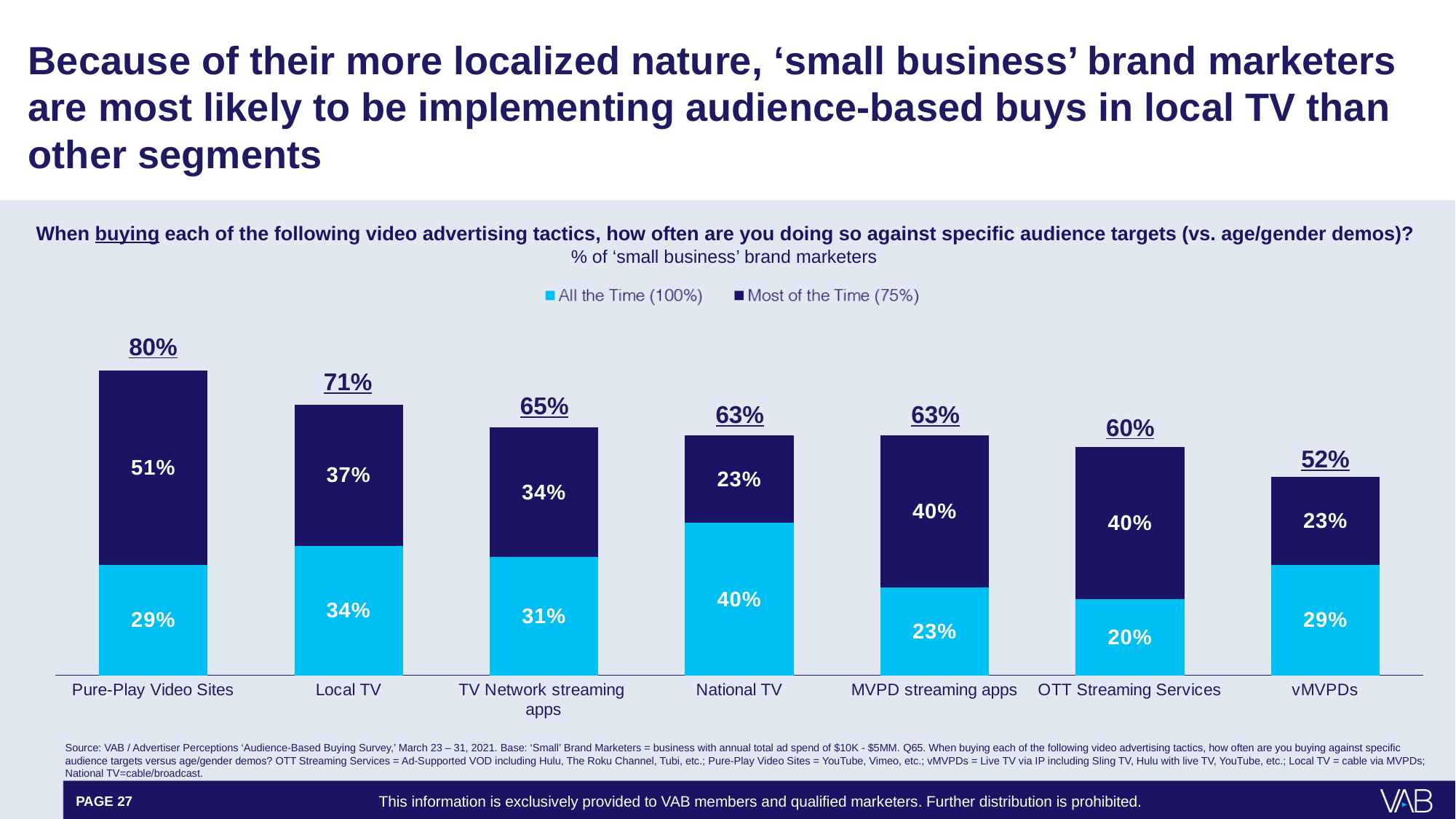
Which category has the highest total? Pure-Play Video Sites How many categories are shown on the x axis? 7 What is the total for National TV? 63% What is the difference between the totals for Pure-Play Video Sites and Local TV? 9% How many series does the legend list? 2 Which is larger, the 'All the Time (100%)' value for National TV or for MVPD streaming apps? National TV What is the 'Most of the Time (75%)' value for Pure-Play Video Sites? 51% Which category has the lowest total? vMVPDs What kind of chart is shown? Stacked bar chart What is the 'All the Time (100%)' value for OTT Streaming Services? 20% What is the 'All the Time (100%)' value for Local TV? 34% Which series is shown in light blue? All the Time (100%)